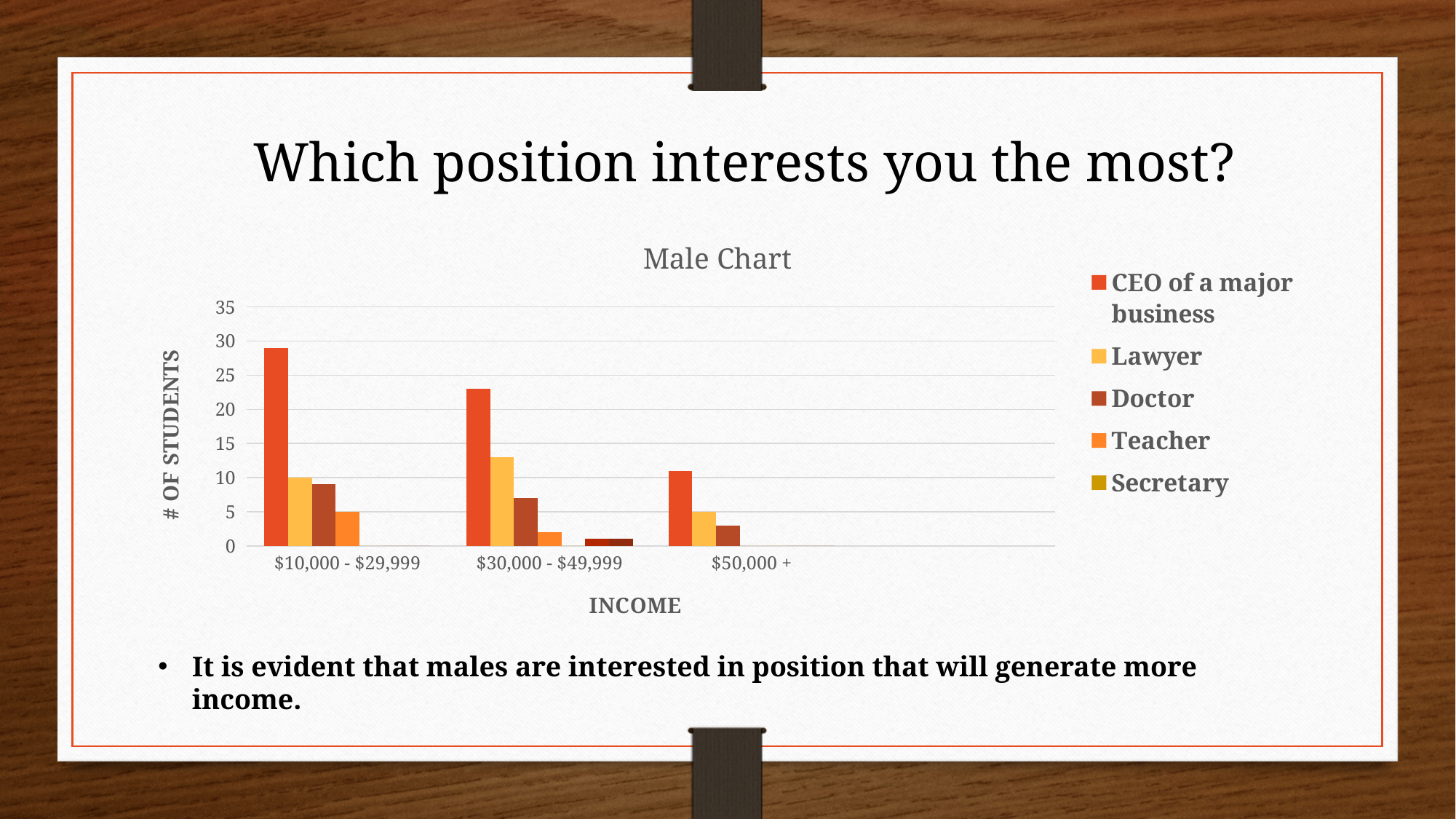
In which income category is the CEO of a major business bar the highest? $10,000 - $29,999 How many series does the legend list? 5 In the $30,000 - $49,999 category, which is larger: Lawyer or Doctor? Lawyer Is the value for Teacher in the $30,000 - $49,999 category greater or less than 5? less Is the value for CEO of a major business in the $10,000 - $29,999 category greater or less than 25? greater Do the CEO of a major business values rise or fall as income increases along the x axis? fall What kind of chart is shown on the slide? bar chart What is the title of the chart? Male Chart Is the value for CEO of a major business in the $50,000 + category greater or less than 15? less What is the label on the vertical axis? # OF STUDENTS How many income categories are shown on the x axis? 3